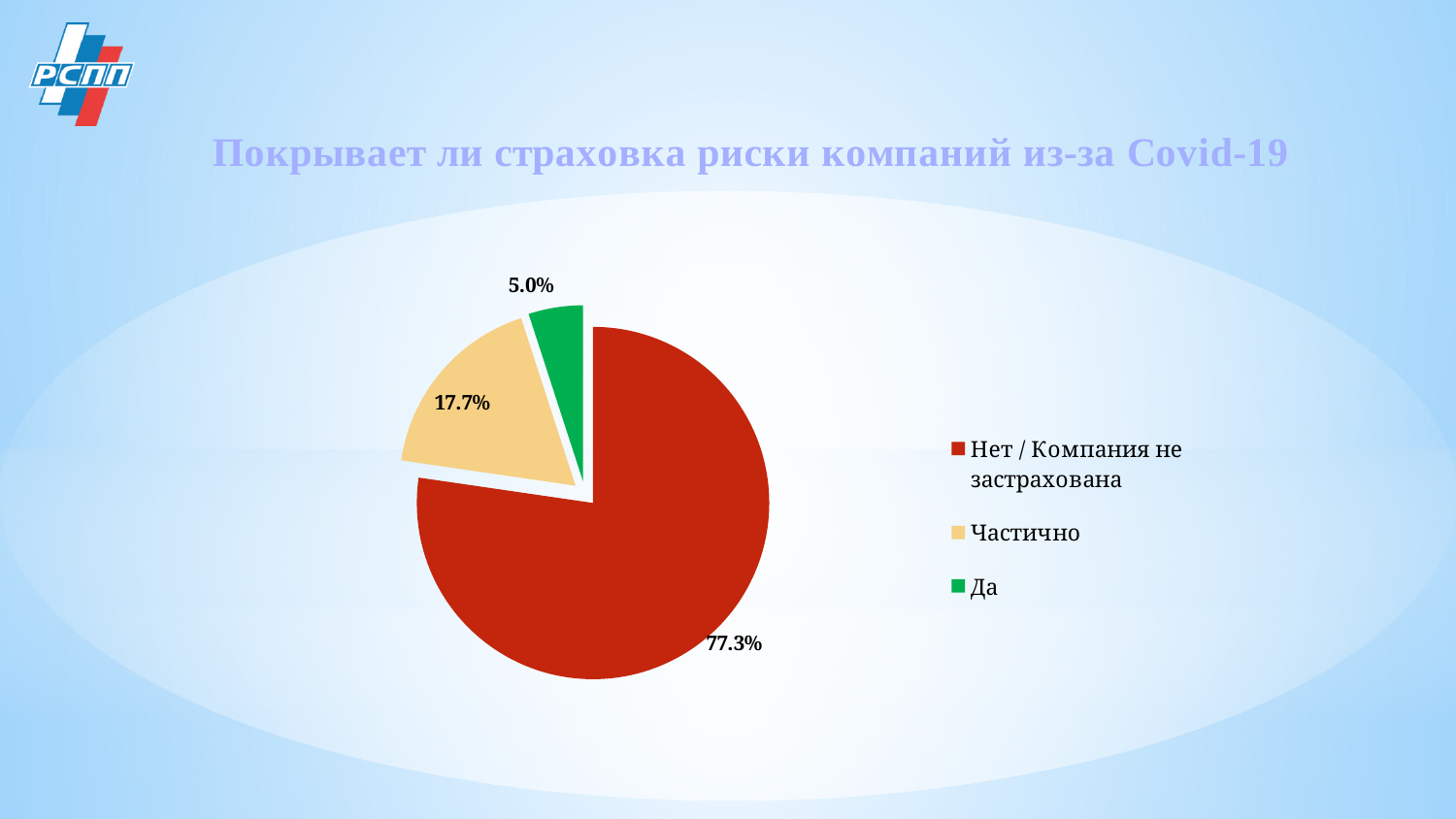
What is the title of the chart on the slide? Покрывает ли страховка риски компаний из-за Covid-19 Which category has the smallest slice of the pie? Да What kind of chart is shown on the slide? Pie chart How many categories does the pie chart show? 3 What share of the pie does the slice "Частично" represent? 17.7% What is the difference in percentage points between the "Нет / Компания не застрахована" slice and the "Частично" slice? 59.6 What share of the pie does the slice "Да" represent? 5.0% What is the difference in percentage points between the "Частично" slice and the "Да" slice? 12.7 What share of the pie does the slice "Нет / Компания не застрахована" represent? 77.3% Which is larger: the share for "Частично" or the share for "Да"? Частично What colour is the slice for "Да" in the pie chart? Green Which category has the largest slice of the pie? Нет / Компания не застрахована